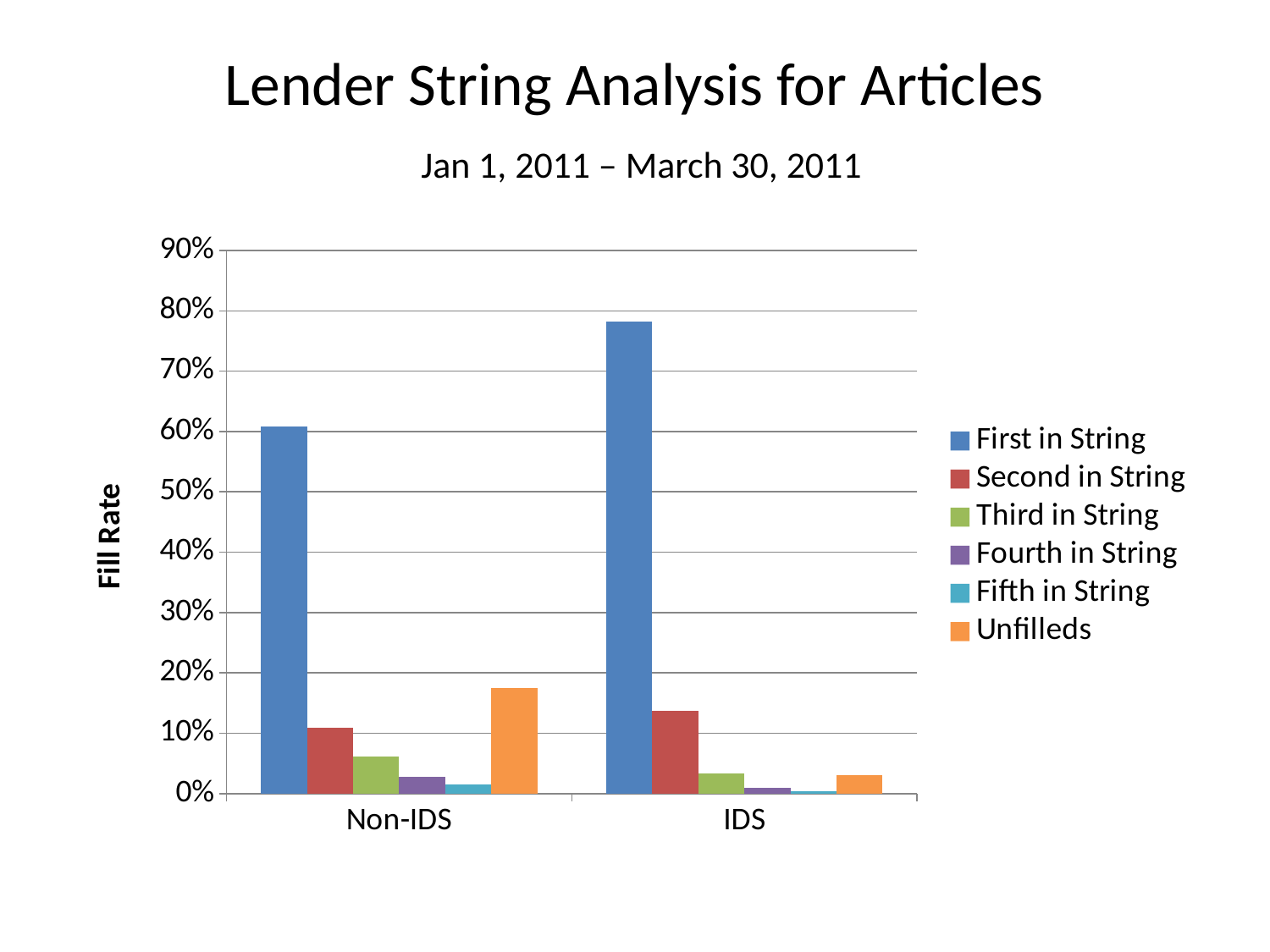
Which series has the highest value for IDS? First in String What kind of chart is shown on the slide? bar chart Is the First in String value for Non-IDS greater or less than 50%? greater How many categories are shown on the x axis? 2 Which category has the larger First in String value, Non-IDS or IDS? IDS Which series has the lowest value for Non-IDS? Fifth in String How many series does the legend list? 6 What is the label on the vertical axis of the chart? Fill Rate Is the Unfilleds value for Non-IDS greater or less than 20%? less Which category has the larger Unfilleds value, Non-IDS or IDS? Non-IDS Is the Second in String value for IDS greater or less than 10%? greater